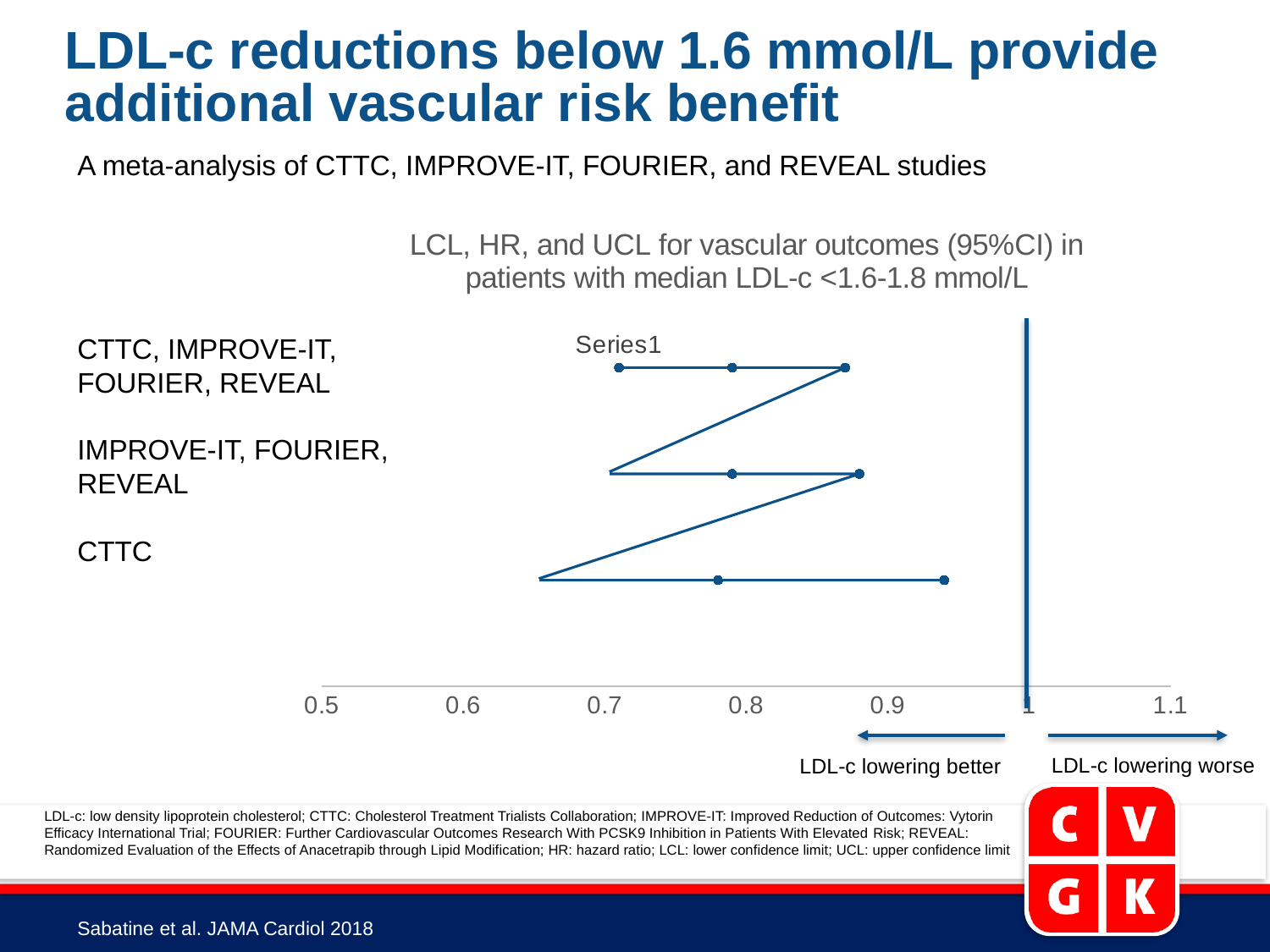
Is the upper confidence limit (rightmost point) for CTTC greater or less than 0.9? greater Is the lower confidence limit (leftmost point) for CTTC greater or less than 0.7? less Which group has the highest upper confidence limit (rightmost point)? CTTC Which group has a wider confidence interval, CTTC or IMPROVE-IT, FOURIER, REVEAL? CTTC Which group has the lowest lower confidence limit (leftmost point)? CTTC Is the upper confidence limit (rightmost point) for CTTC, IMPROVE-IT, FOURIER, REVEAL greater or less than 0.9? less What kind of chart is shown on the slide? Line chart What is the legend entry shown on the chart? Series1 How many series does the chart legend list? 1 What is the title of the chart? LCL, HR, and UCL for vascular outcomes (95%CI) in patients with median LDL-c <1.6-1.8 mmol/L How many study groups are plotted on the chart? 3